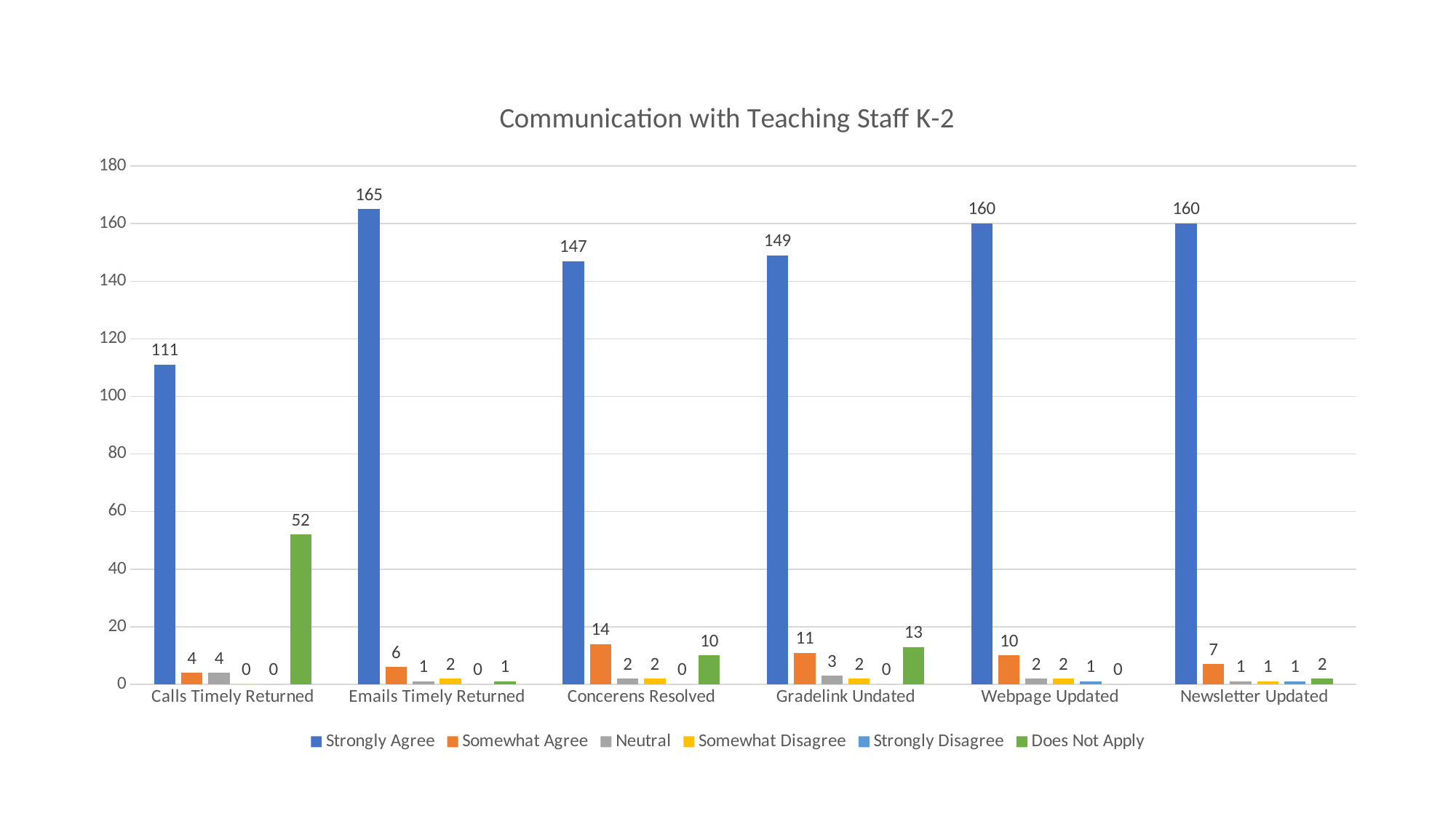
What is the difference between the Strongly Agree values for Emails Timely Returned and Calls Timely Returned? 54 Is the Strongly Agree value for Concerens Resolved greater or less than 140? greater Which category has the lowest Strongly Agree value? Calls Timely Returned What is the Strongly Agree value for Emails Timely Returned? 165 What is the Does Not Apply value for Calls Timely Returned? 52 What is the title of the chart? Communication with Teaching Staff K-2 What kind of chart is shown on the slide? Bar chart How many series does the legend list? 6 How many categories are shown on the x axis? 6 Which is larger, the Does Not Apply value for Gradelink Undated or for Concerens Resolved? Gradelink Undated Which category has the highest Strongly Agree value? Emails Timely Returned What is the Somewhat Agree value for Concerens Resolved? 14